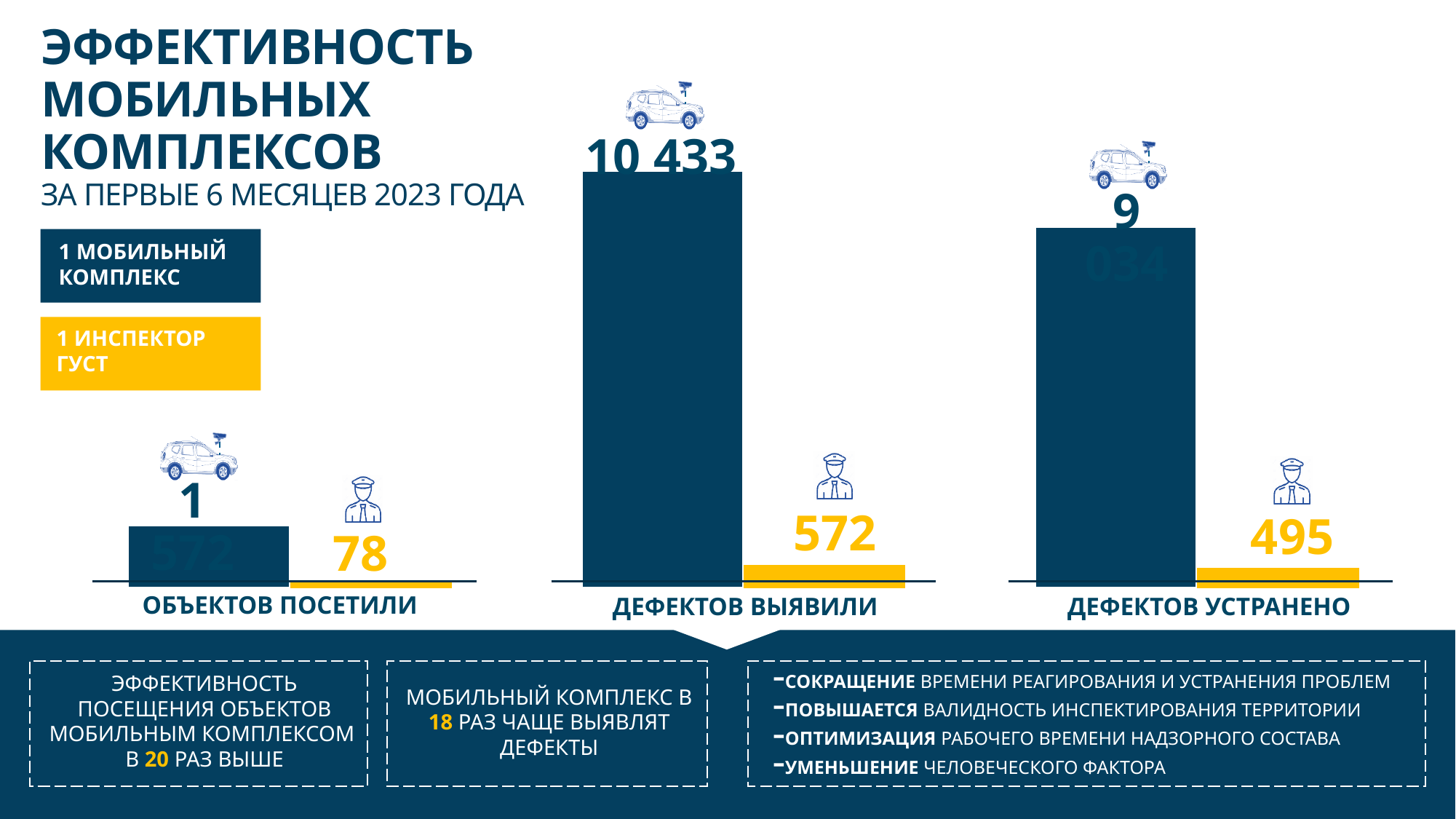
What is the difference between the defects identified and the defects fixed by 1 инспектор ГУСТ? 77 How many defects did 1 мобильный комплекс identify (ДЕФЕКТОВ ВЫЯВИЛИ)? 10 433 In which category is the value for 1 инспектор ГУСТ the lowest? ОБЪЕКТОВ ПОСЕТИЛИ How many defects did 1 инспектор ГУСТ fix (ДЕФЕКТОВ УСТРАНЕНО)? 495 How many defects did 1 инспектор ГУСТ identify (ДЕФЕКТОВ ВЫЯВИЛИ)? 572 What is the difference between the defects identified and the objects visited by 1 инспектор ГУСТ? 494 In the ДЕФЕКТОВ ВЫЯВИЛИ group, which is larger: the value for 1 мобильный комплекс or for 1 инспектор ГУСТ? 1 мобильный комплекс How many series does the legend list? 2 What kind of chart is shown on the slide? Bar chart How many categories are shown along the bottom of the chart? 3 In which category is the bar for 1 мобильный комплекс the tallest? ДЕФЕКТОВ ВЫЯВИЛИ How many objects did 1 инспектор ГУСТ visit (ОБЪЕКТОВ ПОСЕТИЛИ)? 78